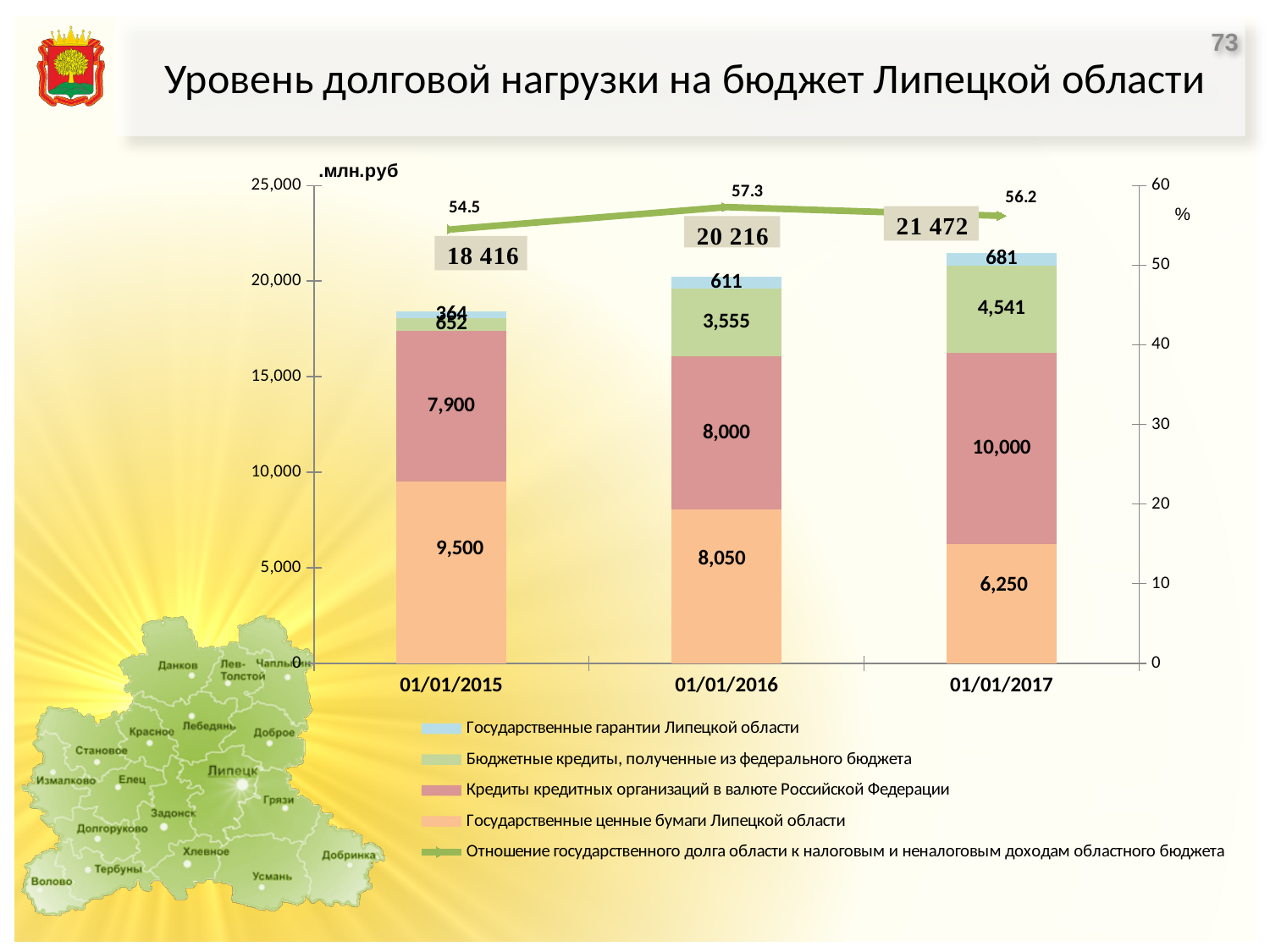
Which is larger: Государственные ценные бумаги Липецкой области on 01/01/2015 or on 01/01/2017? 01/01/2015 What is the value of Государственные ценные бумаги Липецкой области on 01/01/2015? 9,500 How many series does the legend list? 5 On which date is the stacked bar total the lowest? 01/01/2015 On which date does the line series reach its highest value? 01/01/2016 What kind of chart is shown on the slide? Stacked bar chart with a line What is the value of Государственные гарантии Липецкой области on 01/01/2017? 681 What is the value of Кредиты кредитных организаций в валюте Российской Федерации on 01/01/2017? 10,000 What is the value of Бюджетные кредиты, полученные из федерального бюджета on 01/01/2016? 3,555 What is the total of the stacked bar for 01/01/2017? 21 472 What is the value of the line series (Отношение государственного долга области к налоговым и неналоговым доходам областного бюджета) on 01/01/2016? 57.3 What is the difference between Кредиты кредитных организаций в валюте Российской Федерации on 01/01/2017 and on 01/01/2015? 2,100